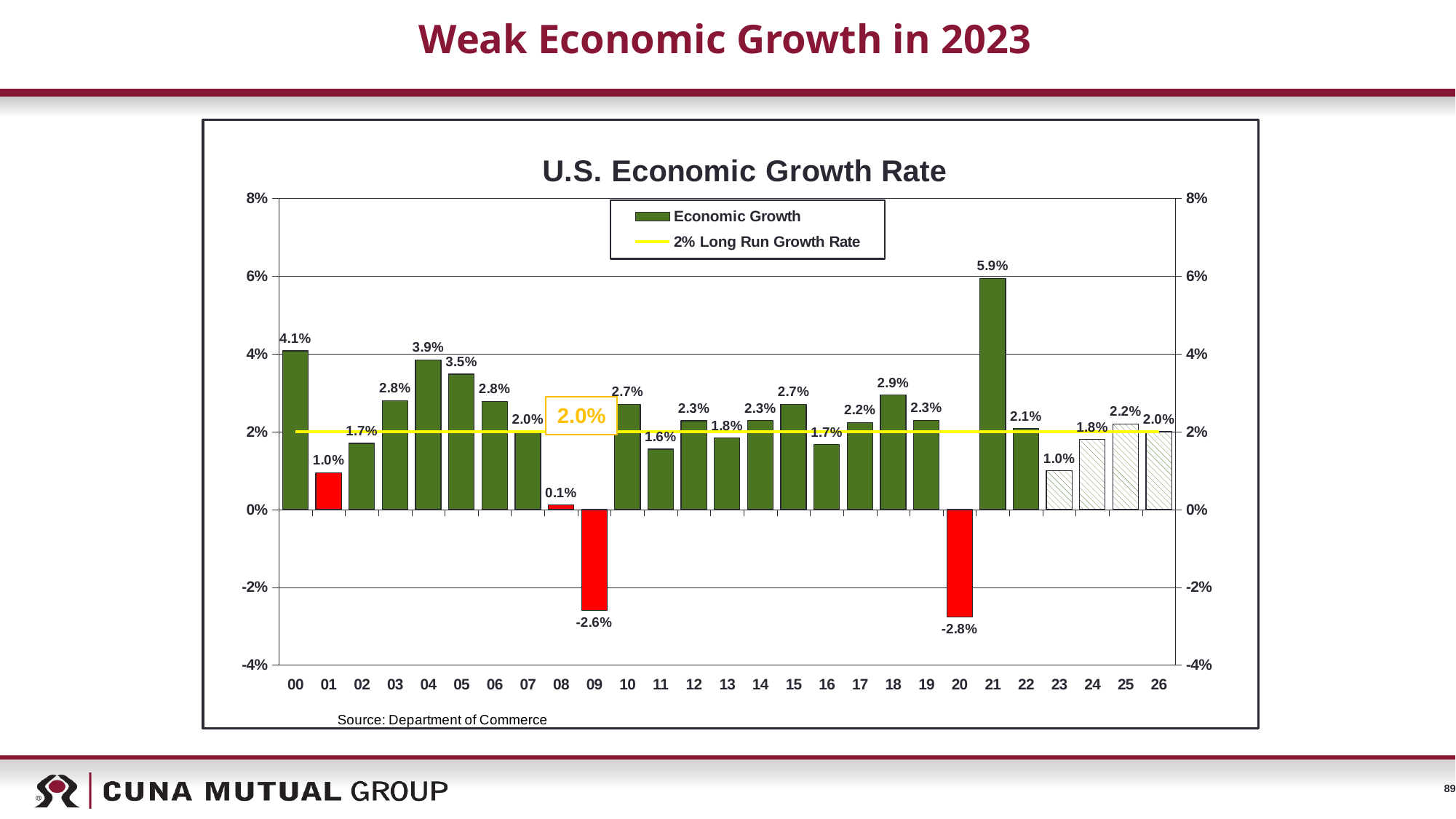
Which year has the lowest economic growth rate on the chart? 20 What is the difference between the growth rate in 2000 (00) and in 2001 (01)? 3.1% What kind of chart is used to show the U.S. Economic Growth Rate? Bar chart How many years are shown on the x axis of the chart? 27 What is the economic growth rate shown for 2009 (09)? -2.6% What is the value of the long run growth rate line shown on the chart? 2.0% What is the economic growth rate shown for 2021 (21)? 5.9% Which year has the highest economic growth rate on the chart? 21 Which year has the larger growth rate, 2004 (04) or 2005 (05)? 04 How many entries does the legend list? 2 What is the source cited for the chart? Department of Commerce What is the economic growth rate shown for 2023 (23)? 1.0%